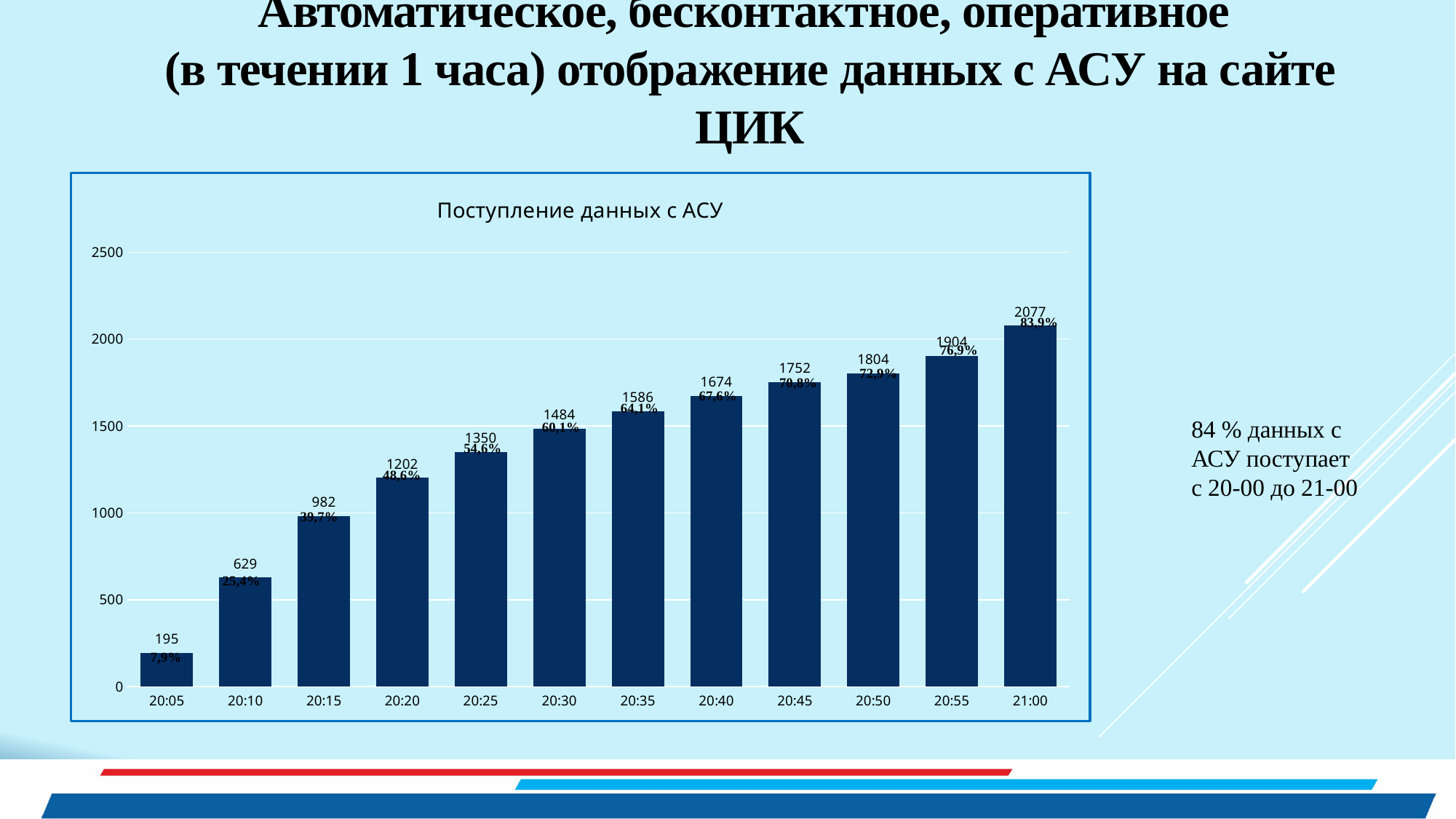
What kind of chart is shown on the slide? bar chart How many time categories are shown on the x axis of the chart? 12 What is the difference between the values for 20:10 and 20:05? 434 Which is larger, the value for 20:20 or the value for 20:15? 20:20 Do the values rise or fall from 20:05 to 21:00? rise Which time has the lowest value in the chart? 20:05 What is the value for 20:05 in the chart? 195 Which time has the highest value in the chart? 21:00 What is the title of the chart? Поступление данных с АСУ What is the difference between the values for 21:00 and 20:55? 173 What is the value for 20:30 in the chart? 1484 What is the value for 21:00 in the chart? 2077